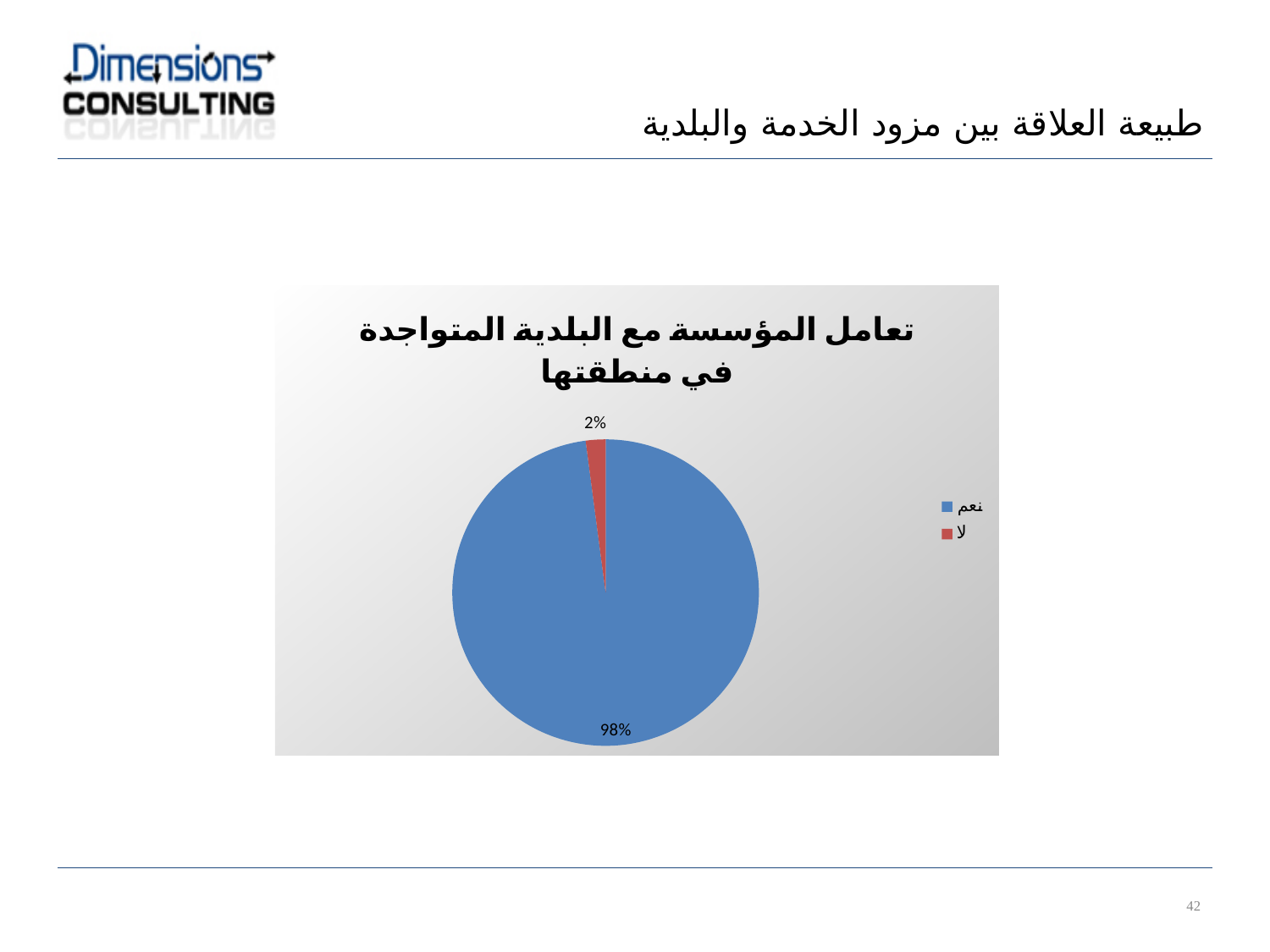
Which category has the smallest slice of the pie? لا What share of the pie does the "نعم" slice represent? 98% Which category has the largest slice of the pie? نعم What is the title of the chart? تعامل المؤسسة مع البلدية المتواجدة في منطقتها What colour is the "لا" slice in the pie chart? red What is the difference in percentage points between the "نعم" and "لا" slices? 96 What share of the pie does the "لا" slice represent? 2% What kind of chart is shown on the slide? pie chart How many slices does the pie chart have? 2 How many entries does the legend list? 2 Which is larger, the "نعم" slice or the "لا" slice? نعم